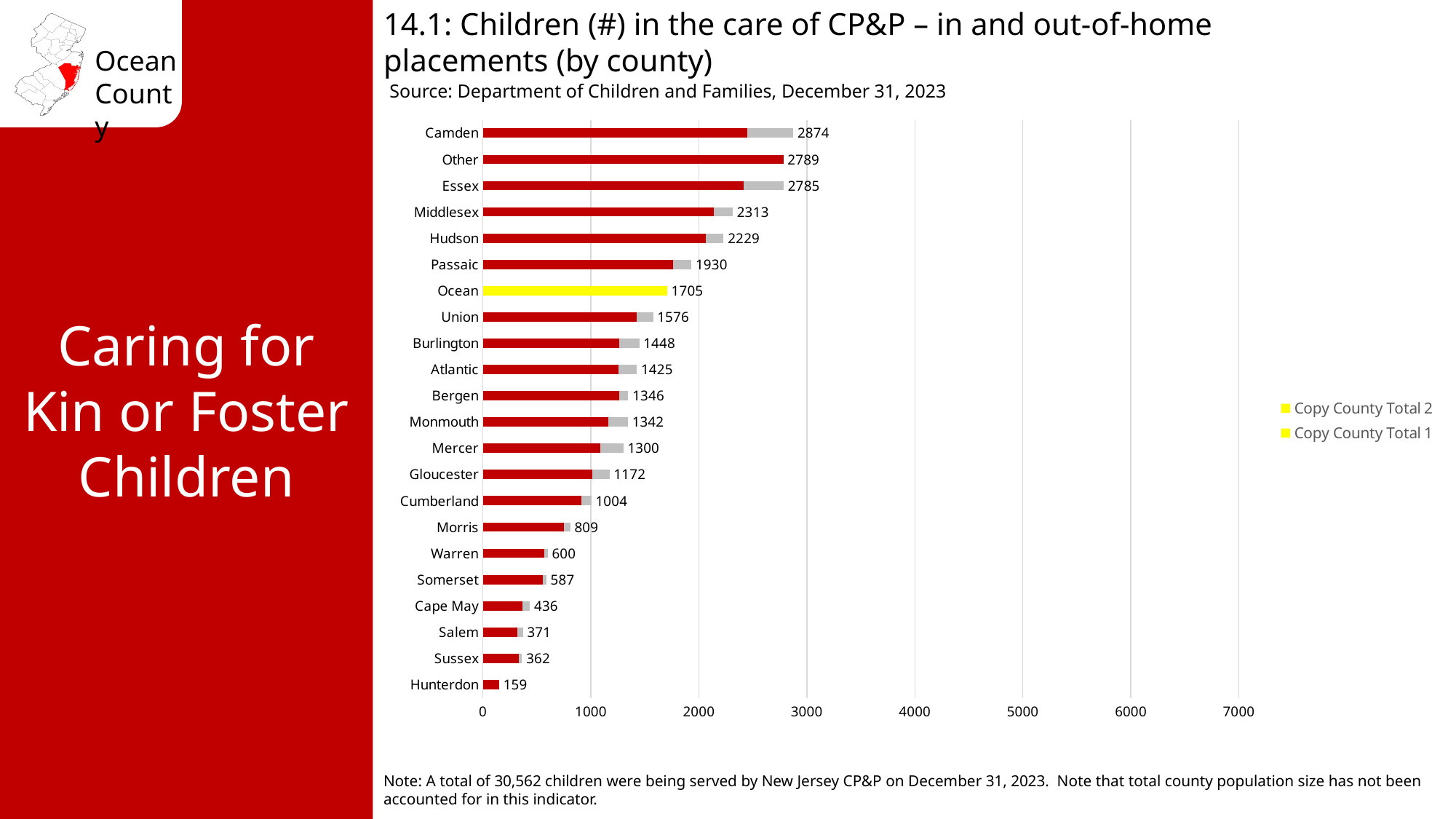
What is the value shown for Hunterdon? 159 What is the value shown for Camden? 2874 How many series does the legend list? 2 Which county has the lowest number of children in the care of CP&P? Hunterdon What is the difference between the values for Ocean and Monmouth? 363 What is the difference between the values for Camden and Ocean? 1169 How many counties (categories) are shown on the chart? 22 Which county has the highest number of children in the care of CP&P? Camden Which has a larger value, Passaic or Ocean? Passaic What kind of chart is shown on the slide? bar chart What is the total number of children in the care of CP&P for Ocean County? 1705 Is the value for Cumberland greater or less than 2000? less